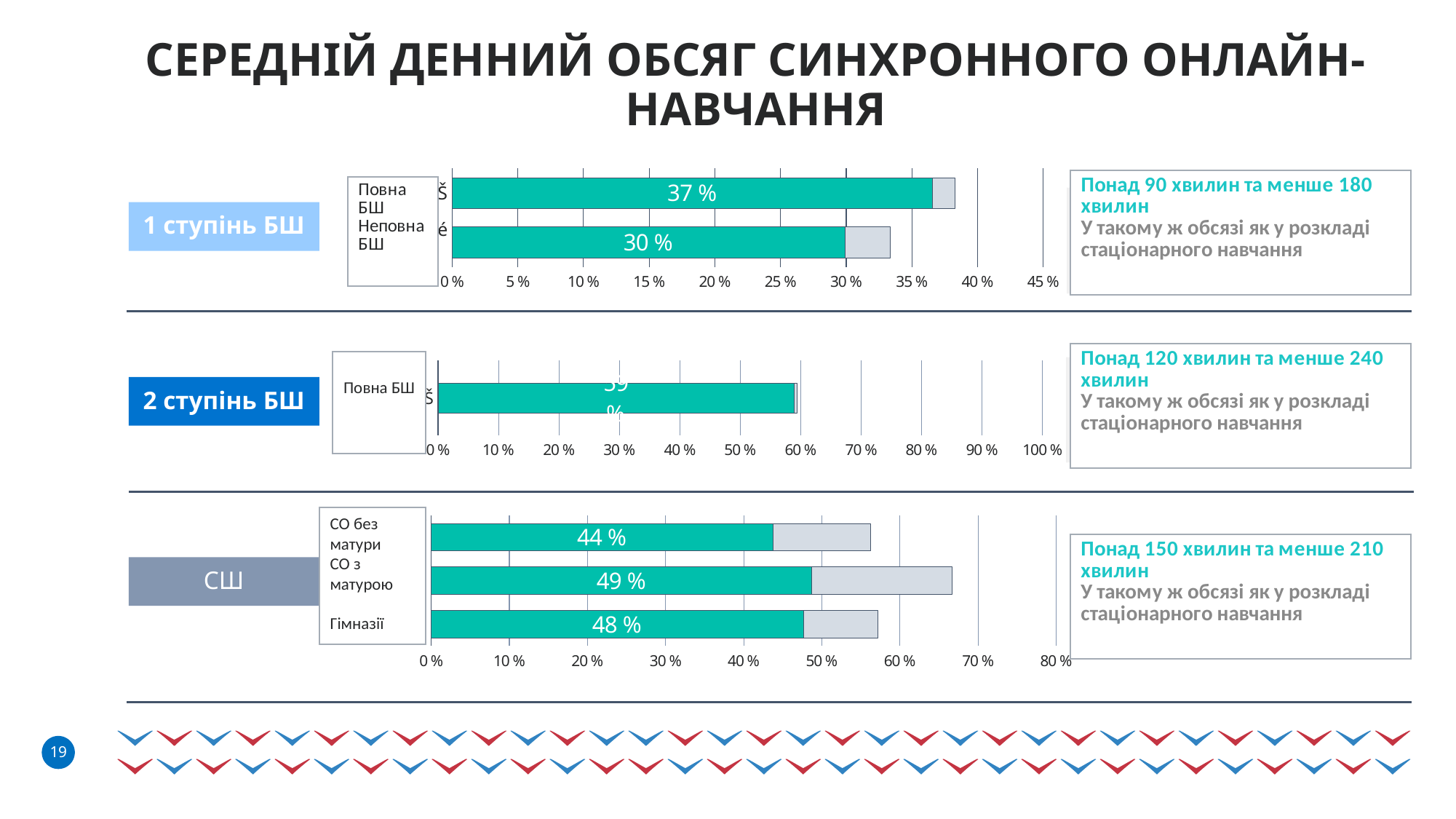
In the chart for 2 ступінь БШ, is the value for Повна БШ greater or less than 50 %? greater In the chart for 2 ступінь БШ, what is the value for Повна БШ? 59 % In the chart for СШ, what is the value for СО без матури? 44 % In the chart for СШ, which category has the lowest labelled value? СО без матури What type of chart is used in the СШ row? bar chart In the chart for СШ, what is the value for Гімназії? 48 % In the chart for СШ, what is the value for СО з матурою? 49 % In the chart for 1 ступінь БШ, what is the value for Повна БШ? 37 % In the chart for 1 ступінь БШ, what is the value for Неповна БШ? 30 % In the chart for 1 ступінь БШ, what is the difference between the values for Повна БШ and Неповна БШ? 7 % In the chart for СШ, how many categories are shown? 3 In the chart for СШ, what is the difference between the values for СО з матурою and СО без матури? 5 %